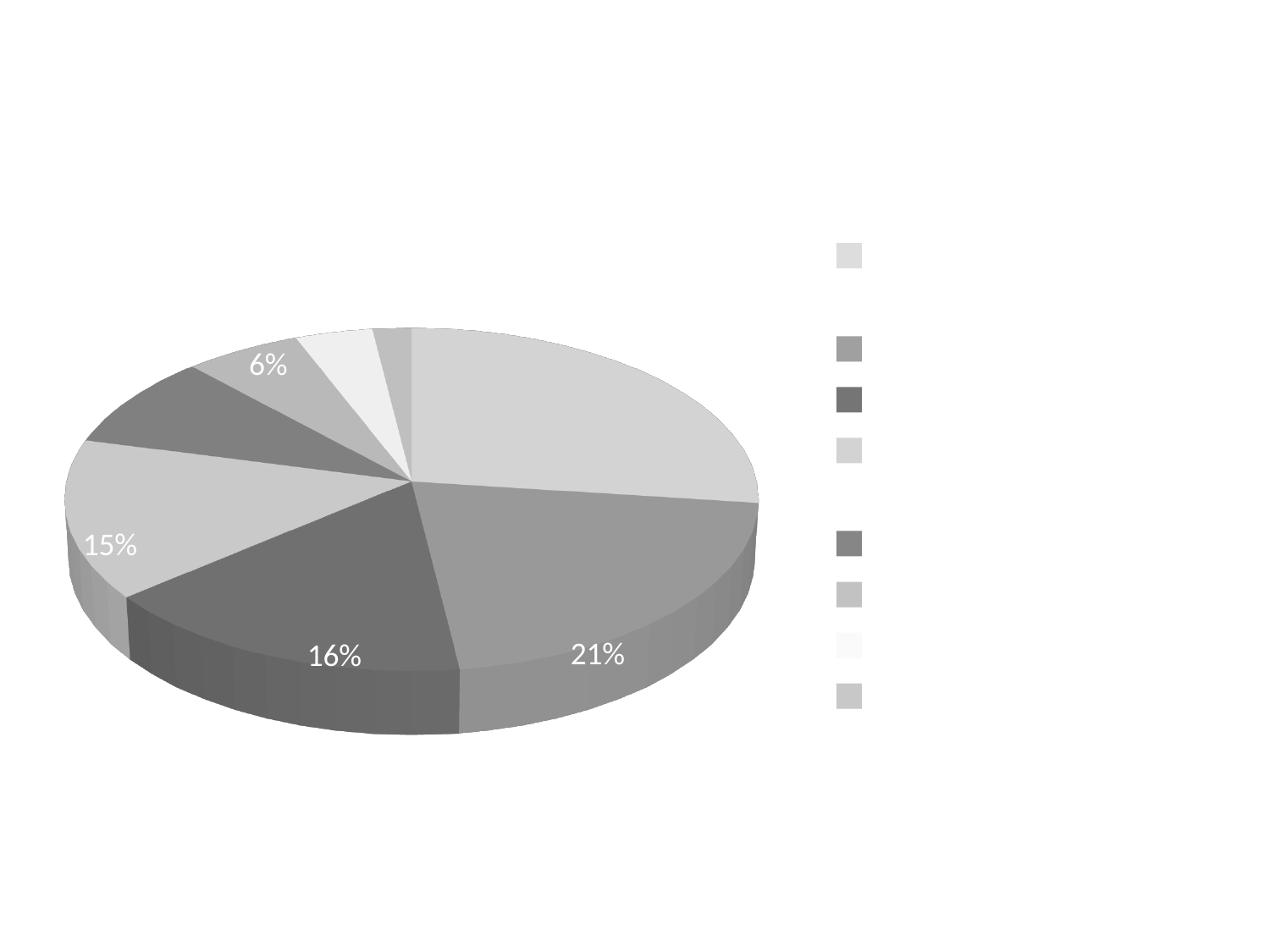
What is the smallest percentage label printed on the pie chart? 6% How many slices of the pie chart have a percentage label printed on them? 4 What kind of chart is shown on the slide? pie chart What is the largest percentage label printed on the pie chart? 21% What is the combined share of the slices labelled 21%, 16%, 15% and 6%? 58% What is the difference between the slice labelled 16% and the slice labelled 15%? 1% How many slices does the pie chart have? 8 Which is larger, the slice labelled 21% or the slice labelled 15%? the slice labelled 21% Do the legend entries of the pie chart have readable text labels? No How many entries does the legend of the pie chart list? 8 What is the difference between the slice labelled 21% and the slice labelled 16%? 5% Does the pie chart have a title? No